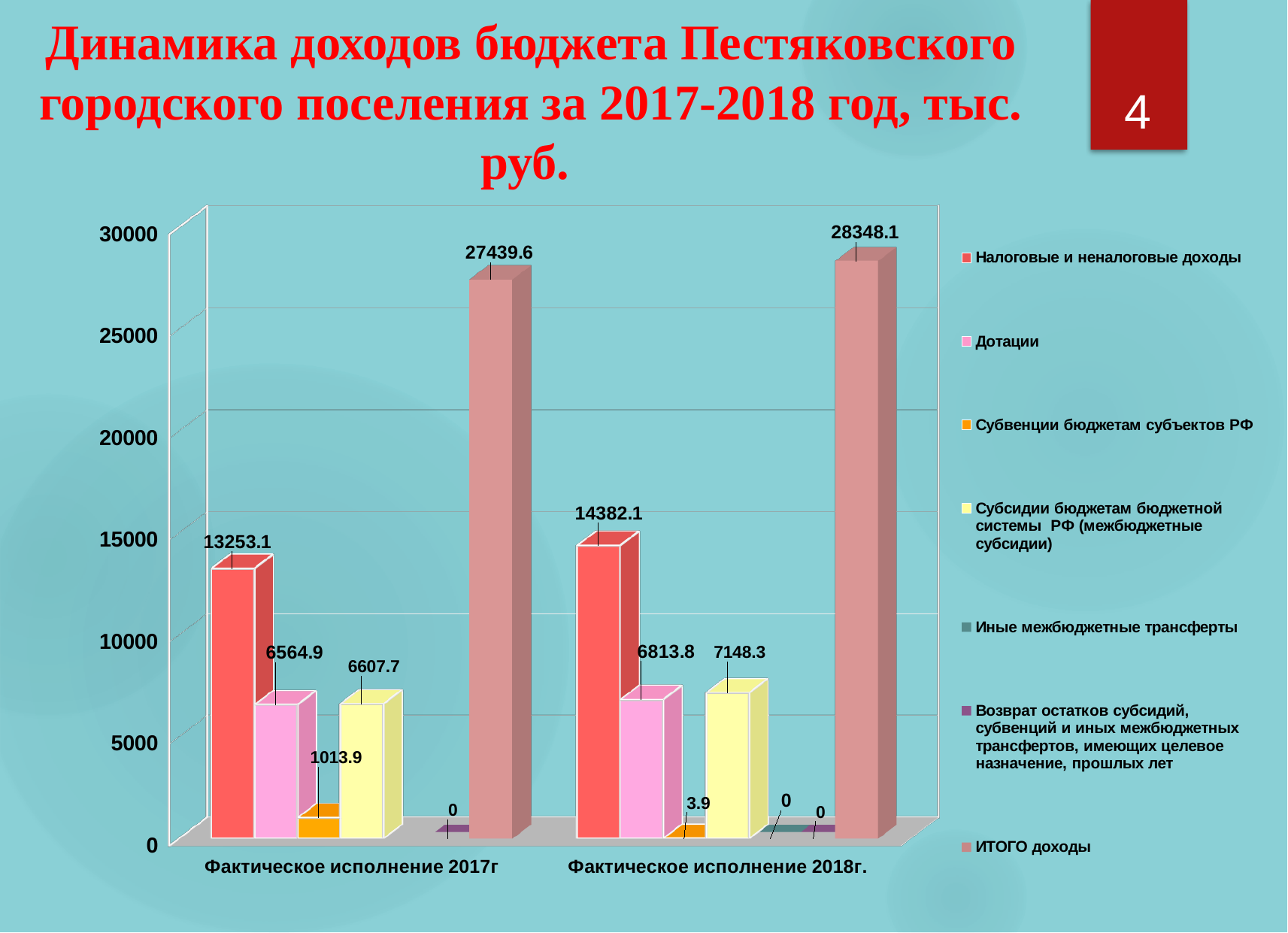
What is the value of Субвенции бюджетам субъектов РФ for Фактическое исполнение 2017г? 1013.9 Which is larger: Дотации or Субсидии бюджетам бюджетной системы РФ in Фактическое исполнение 2018г.? Субсидии бюджетам бюджетной системы РФ By how much did ИТОГО доходы change from Фактическое исполнение 2017г to Фактическое исполнение 2018г.? 908.5 How many series are listed in the legend? 7 What is the value of Налоговые и неналоговые доходы for Фактическое исполнение 2017г? 13253.1 What is the value of ИТОГО доходы for Фактическое исполнение 2018г.? 28348.1 What is the value of Субсидии бюджетам бюджетной системы РФ (межбюджетные субсидии) for Фактическое исполнение 2018г.? 7148.3 What is the difference between Налоговые и неналоговые доходы in 2018 and in 2017? 1129.0 What is the value of Дотации for Фактическое исполнение 2018г.? 6813.8 Which series has the lowest value in Фактическое исполнение 2018г. among those with non-zero values? Субвенции бюджетам субъектов РФ What type of chart is shown on the slide? Bar chart Does the value of Налоговые и неналоговые доходы rise or fall from 2017 to 2018? Rise